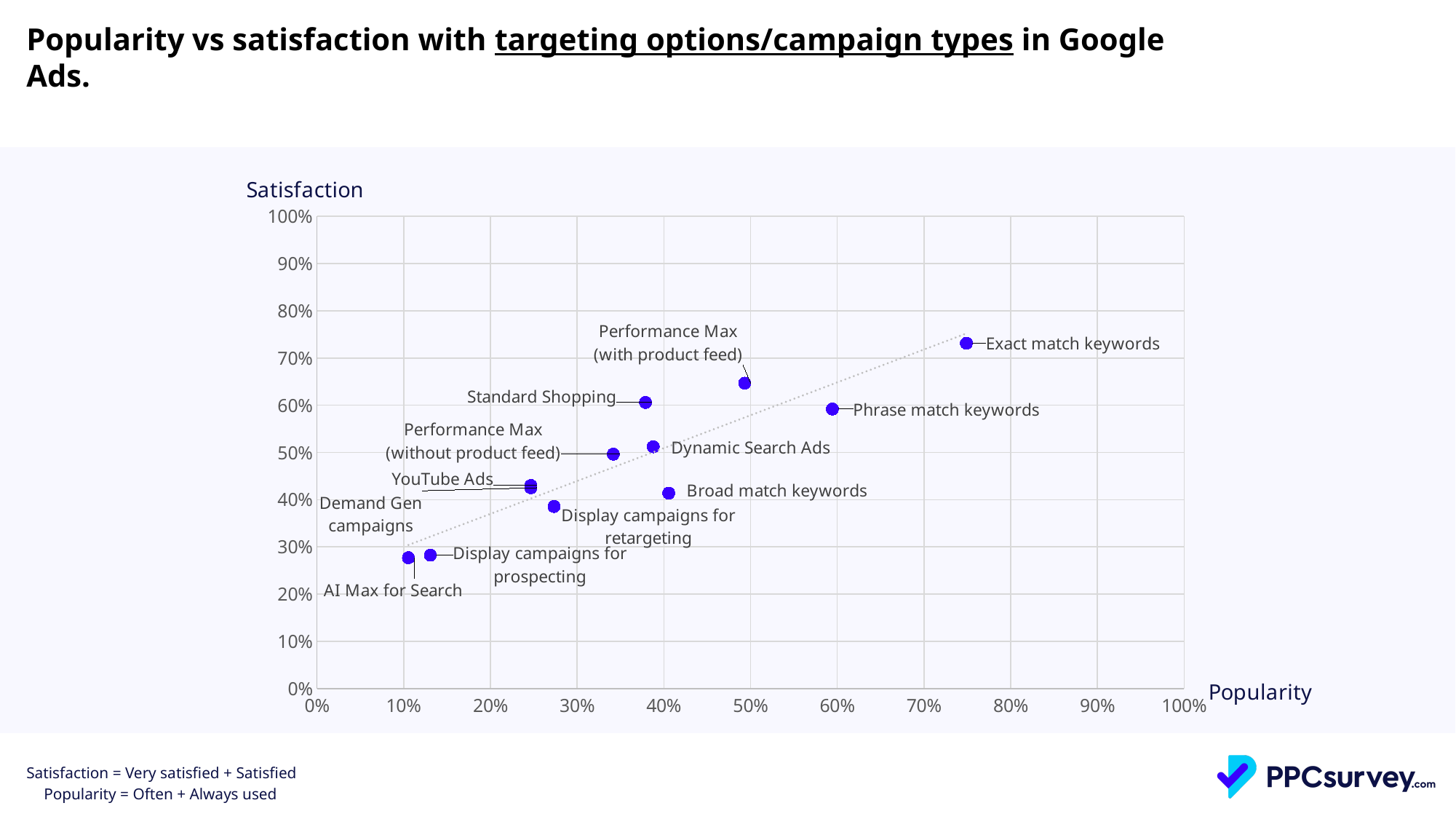
Which targeting option/campaign type has the highest popularity? Exact match keywords Which has higher satisfaction: Performance Max (with product feed) or Broad match keywords? Performance Max (with product feed) Which targeting option/campaign type has the highest satisfaction? Exact match keywords Which has higher popularity: Phrase match keywords or Standard Shopping? Phrase match keywords Is the satisfaction for Exact match keywords greater or less than 70%? greater Is the satisfaction for AI Max for Search greater or less than 30%? less What is the label of the horizontal axis of the chart? Popularity What kind of chart is shown on the slide? Scatter chart Is the popularity of Phrase match keywords greater or less than 50%? greater How many targeting options/campaign types are plotted on the chart? 12 Which targeting option/campaign type has the lowest popularity? AI Max for Search